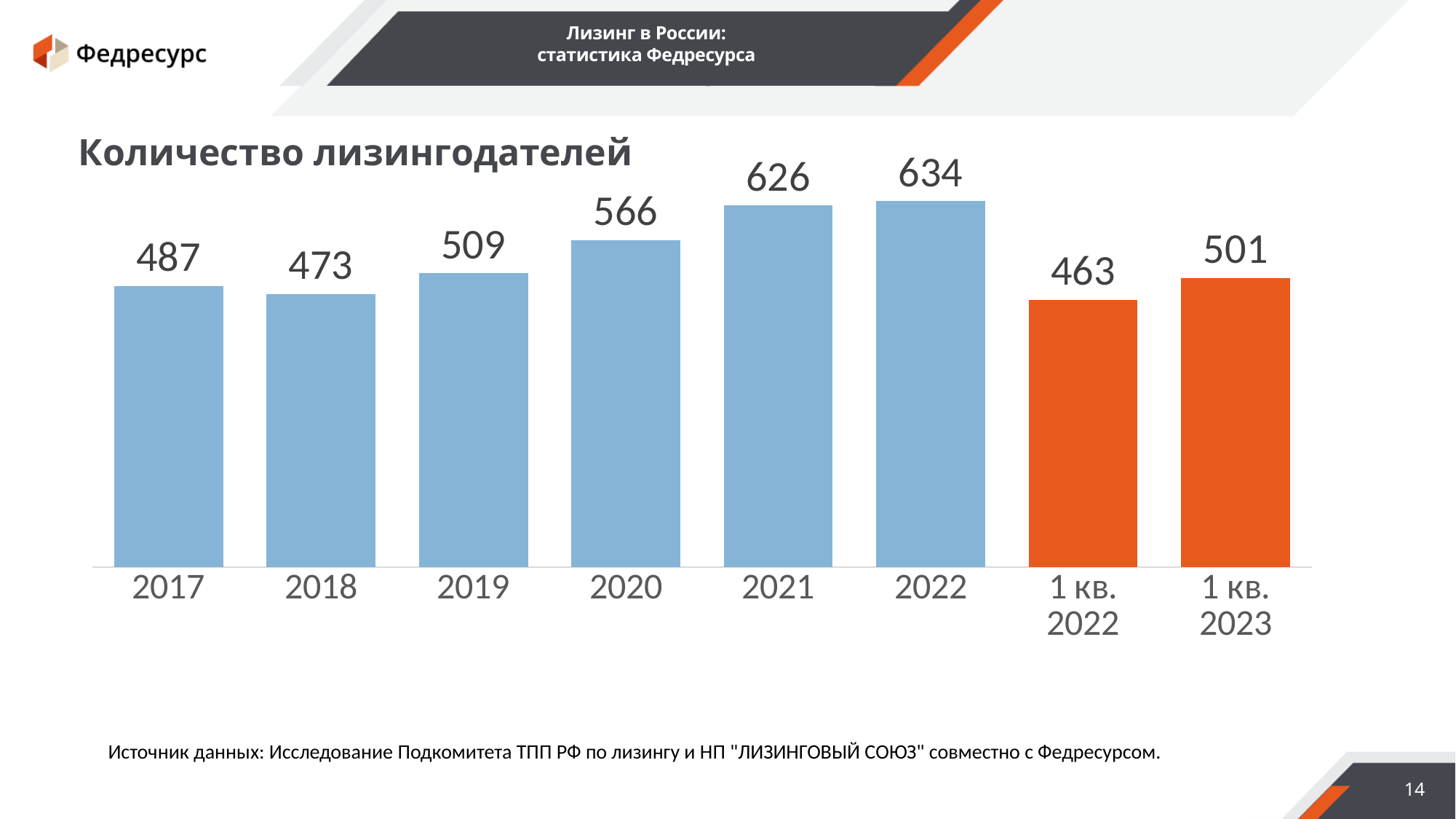
How many bars are shown in the chart? 8 What value is shown for 2018? 473 What is the number of lessors shown for 2020? 566 What is the title of the chart? Количество лизингодателей What is the difference between the values for 2022 and 2021? 8 Which category has the highest value? 2022 What kind of chart is shown on the slide? Bar chart Do the values rise or fall from 2018 to 2022? Rise Which category has the lowest value? 1 кв. 2022 Which is larger, the value for 2017 or the value for 2019? 2019 What is the difference between the values for 1 кв. 2023 and 1 кв. 2022? 38 What value is shown for 1 кв. 2023? 501